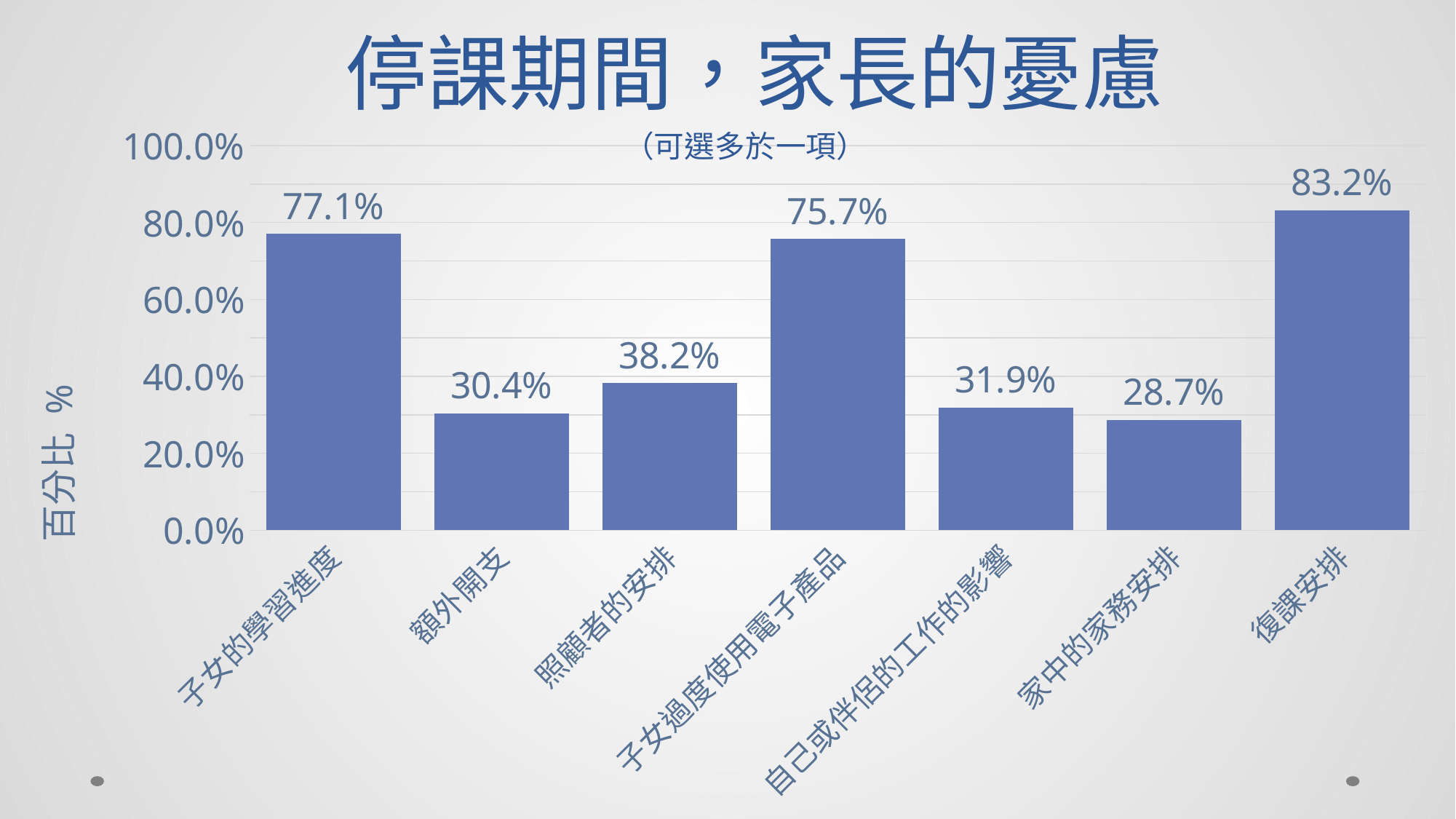
Which is larger, the value for 子女的學習進度 or the value for 子女過度使用電子產品? 子女的學習進度 What is the difference between the values for 照顧者的安排 and 額外開支? 7.8% What is the difference between the values for 復課安排 and 子女的學習進度? 6.1% What is the value for 復課安排? 83.2% How many categories are shown in the chart? 7 What is the title of the chart? 停課期間，家長的憂慮 Which category has the highest value? 復課安排 Is the value for 照顧者的安排 greater or less than 40.0%? less What is the value for 額外開支? 30.4% Which category has the lowest value? 家中的家務安排 What is the value for 子女過度使用電子產品? 75.7% What kind of chart is shown on the slide? bar chart